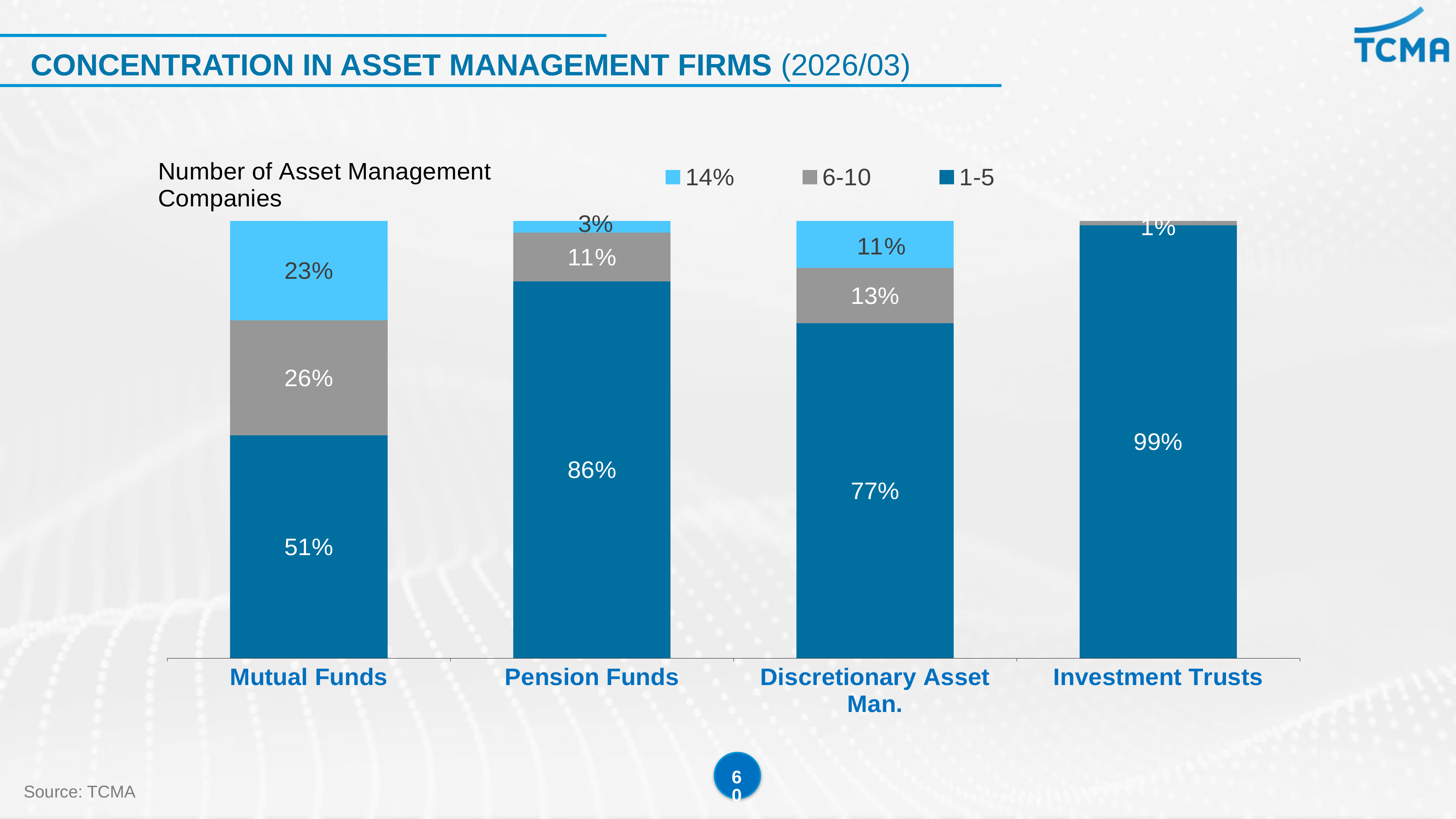
What is the total of the stacked bar for Mutual Funds? 100% Which category has the lowest value for the 1-5 series? Mutual Funds How many categories are shown on the x axis? 4 How many series does the legend list? 3 What is the value of the 6-10 series for Discretionary Asset Man.? 13% What is the difference between the 1-5 value for Pension Funds and the 1-5 value for Mutual Funds? 35 percentage points What is the value of the 1-5 series for Investment Trusts? 99% What is the value of the light blue series (labelled '14%' in the legend) for Pension Funds? 3% Which category has the highest value for the 1-5 series? Investment Trusts Which is larger: the 6-10 value for Mutual Funds or the 6-10 value for Pension Funds? Mutual Funds What is the value of the 1-5 series for Mutual Funds? 51% What kind of chart is shown on the slide? Stacked bar chart